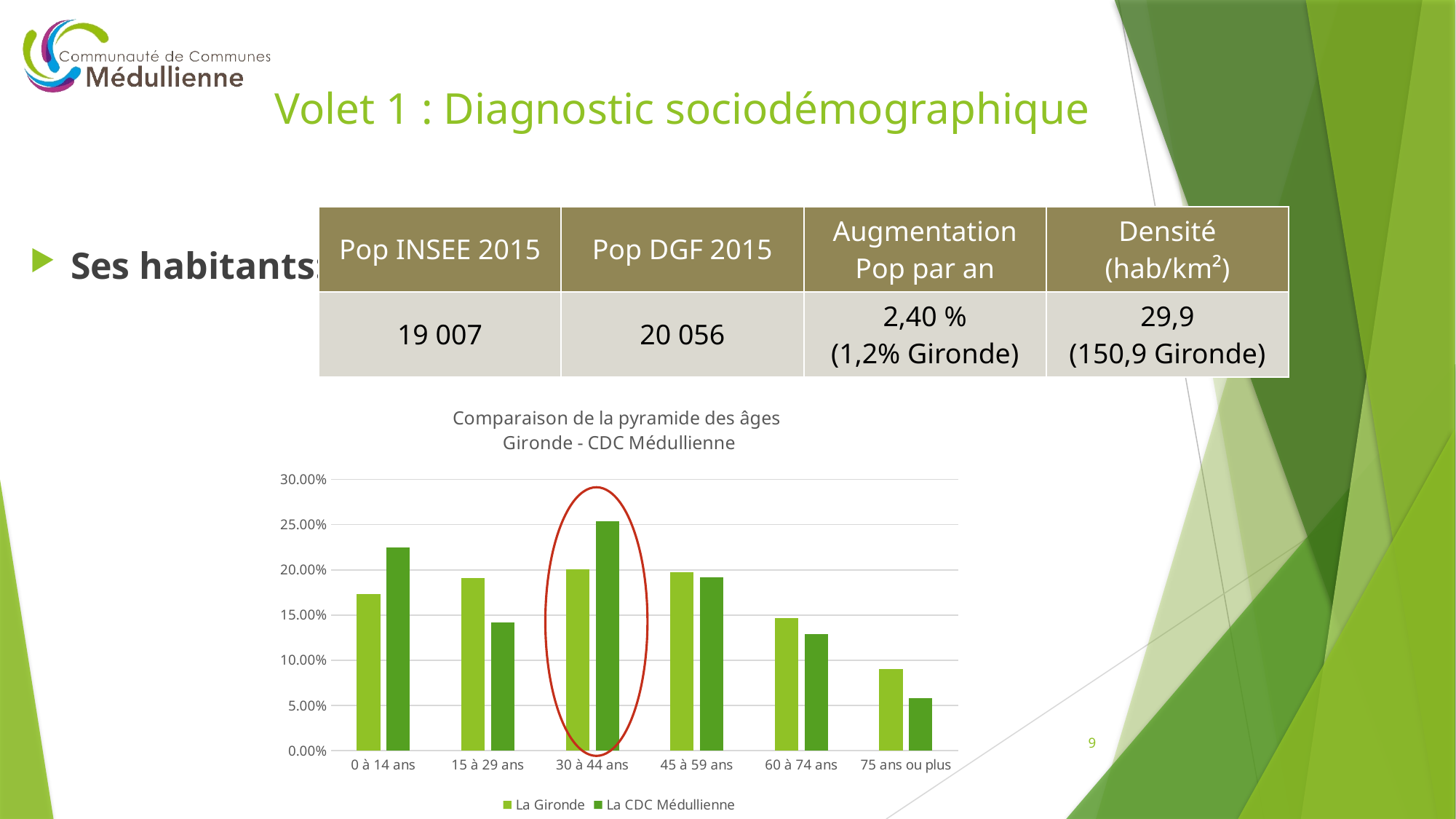
For the 15 à 29 ans category, which series has the larger value, La Gironde or La CDC Médullienne? La Gironde Which age category is highlighted with a red circle on the chart? 30 à 44 ans How many age categories are shown on the x axis of the chart? 6 Which age category has the highest value for La CDC Médullienne? 30 à 44 ans How many series does the chart legend list? 2 Which age category has the lowest value for La Gironde? 75 ans ou plus Do the values for La CDC Médullienne rise or fall from 30 à 44 ans to 75 ans ou plus? fall Is the value for La CDC Médullienne in the 30 à 44 ans category greater or less than 20.00%? greater Is the value for La Gironde in the 75 ans ou plus category greater or less than 10.00%? less For the 0 à 14 ans category, which series has the larger value, La Gironde or La CDC Médullienne? La CDC Médullienne What kind of chart is shown on the slide? Bar chart Which age category has the lowest value for La CDC Médullienne? 75 ans ou plus